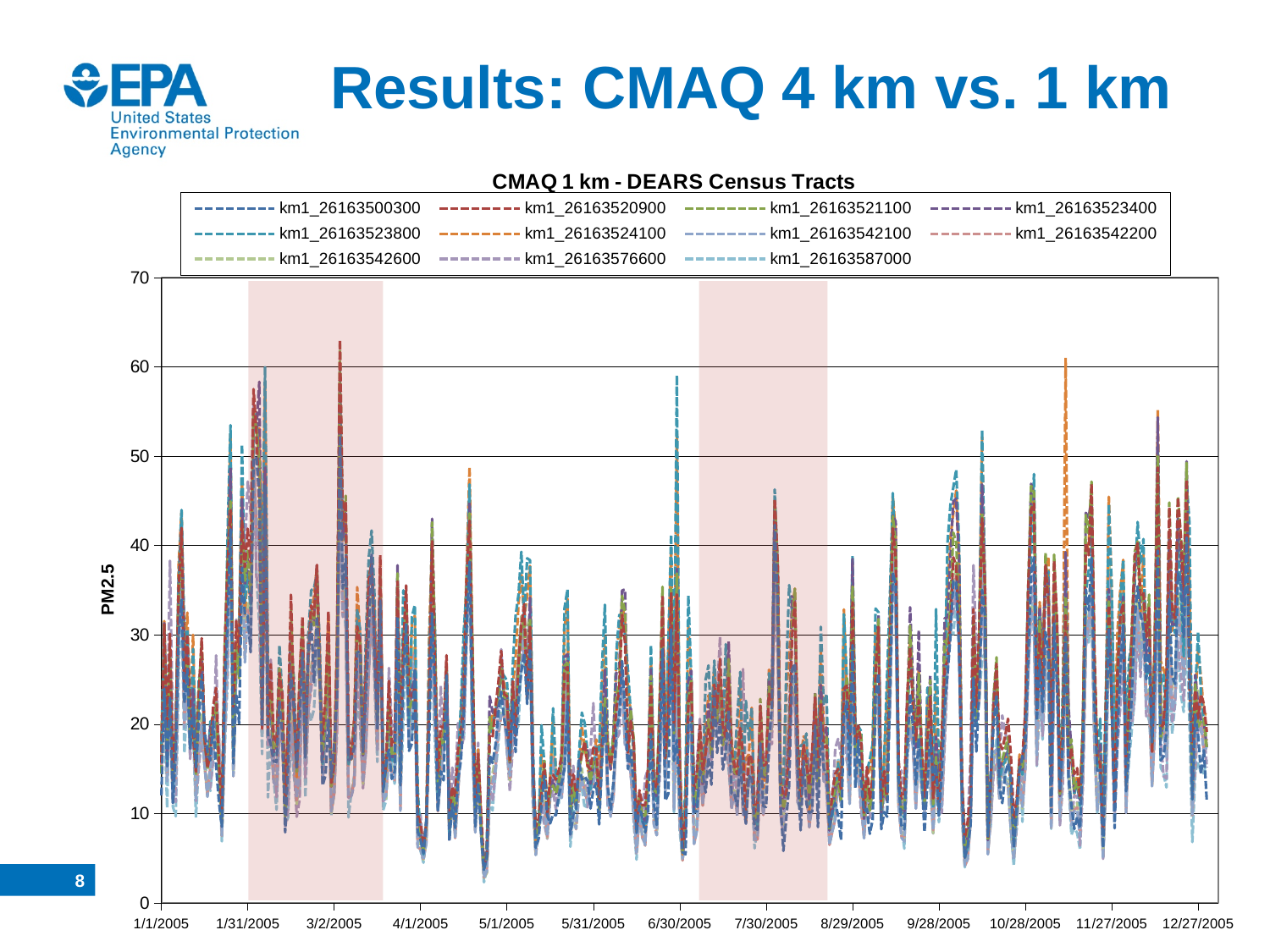
What is the last date label on the horizontal axis? 12/27/2005 Is the peak near 3/2/2005 greater or less than 50? greater What kind of chart is shown on the slide? line chart What is the title of the chart? CMAQ 1 km - DEARS Census Tracts What is the first date label on the horizontal axis? 1/1/2005 How many series does the legend list? 11 What is the name of the first series listed in the legend? km1_26163500300 What is the label on the vertical axis of the chart? PM2.5 Is the highest peak plotted on the chart greater or less than 60? greater Is the lowest value plotted on the chart greater or less than 10? less How many date labels are shown along the horizontal axis? 13 What is the maximum value shown on the vertical axis? 70